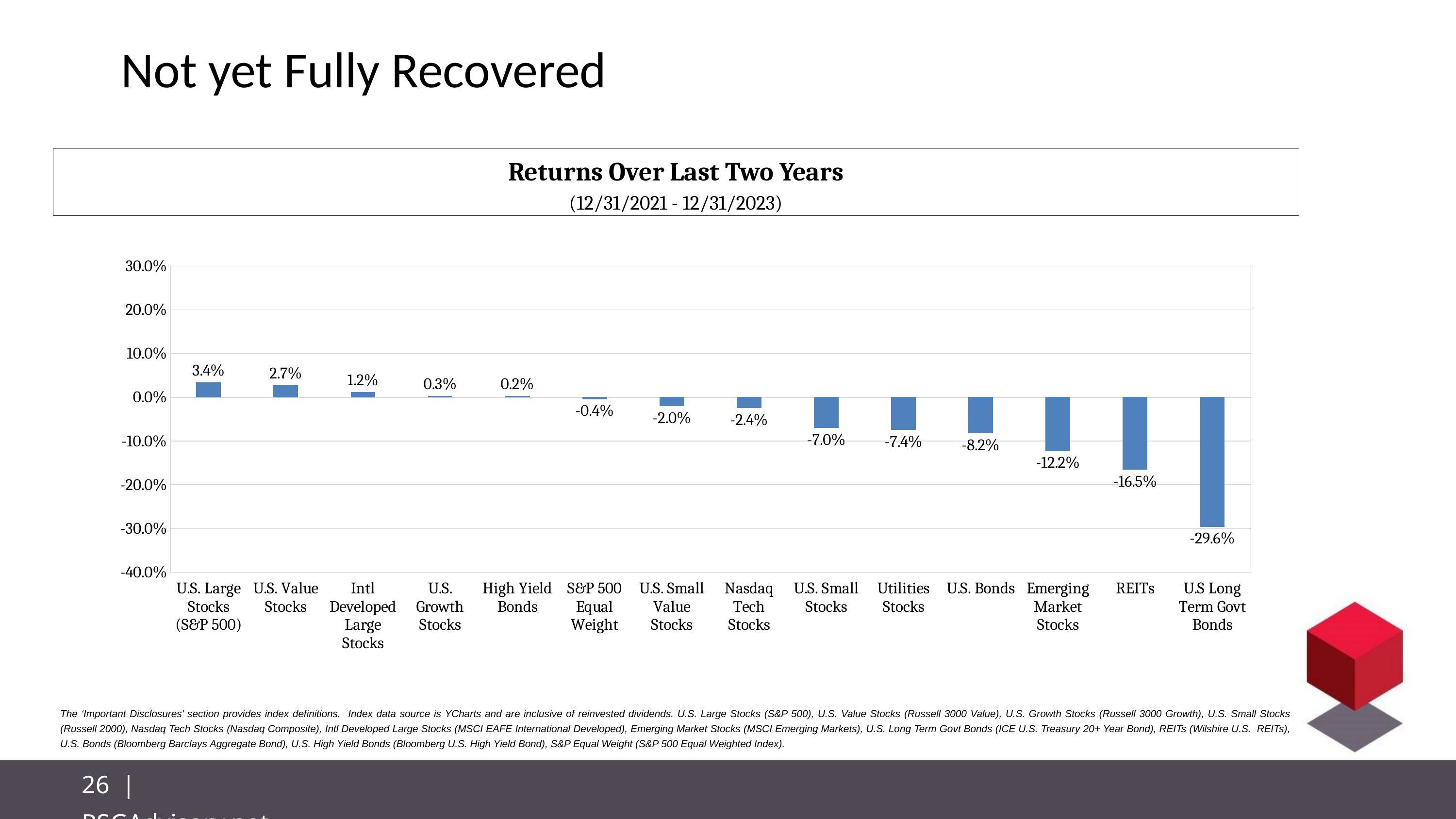
What is the title of the chart? Returns Over Last Two Years Which has a higher return, Nasdaq Tech Stocks or U.S. Small Stocks? Nasdaq Tech Stocks Which category has the lowest return? U.S Long Term Govt Bonds What is the return for U.S. Large Stocks (S&P 500)? 3.4% What is the return for Emerging Market Stocks? -12.2% What kind of chart is shown on the slide? Bar chart What is the difference between the returns for U.S. Large Stocks (S&P 500) and U.S. Value Stocks? 0.7% Is the value for U.S Long Term Govt Bonds greater or less than -20.0%? less How many categories are shown in the chart? 14 Which category has the highest return? U.S. Large Stocks (S&P 500) What is the return for REITs? -16.5% What is the difference between the returns for Utilities Stocks and U.S. Bonds? 0.8%